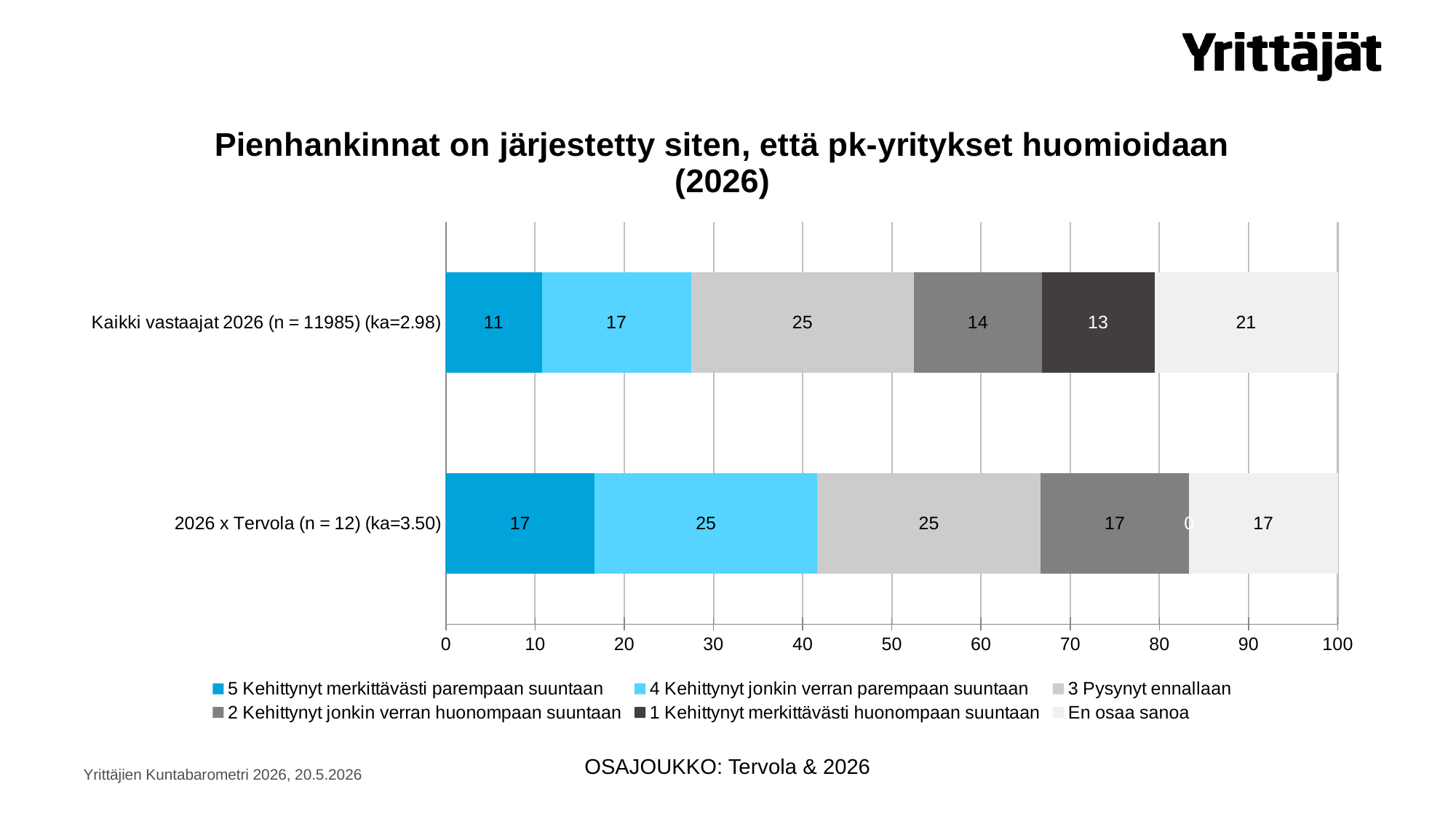
What is the title of the chart? Pienhankinnat on järjestetty siten, että pk-yritykset huomioidaan (2026) Which series has the highest value for "Kaikki vastaajat 2026 (n = 11985) (ka=2.98)"? 3 Pysynyt ennallaan Which category has the higher value for "4 Kehittynyt jonkin verran parempaan suuntaan"? 2026 x Tervola (n = 12) (ka=3.50) What is the value of "1 Kehittynyt merkittävästi huonompaan suuntaan" for "2026 x Tervola (n = 12) (ka=3.50)"? 0 What type of chart is shown on the slide? Stacked bar chart What is the difference between the "5 Kehittynyt merkittävästi parempaan suuntaan" values of "2026 x Tervola (n = 12) (ka=3.50)" and "Kaikki vastaajat 2026 (n = 11985) (ka=2.98)"? 6 Which series has the lowest value for "Kaikki vastaajat 2026 (n = 11985) (ka=2.98)"? 5 Kehittynyt merkittävästi parempaan suuntaan How many categories (bars) are shown in the chart? 2 What is the value of "5 Kehittynyt merkittävästi parempaan suuntaan" for "2026 x Tervola (n = 12) (ka=3.50)"? 17 What is the value of "En osaa sanoa" for "Kaikki vastaajat 2026 (n = 11985) (ka=2.98)"? 21 What is the value of "3 Pysynyt ennallaan" for "Kaikki vastaajat 2026 (n = 11985) (ka=2.98)"? 25 How many series does the legend list? 6